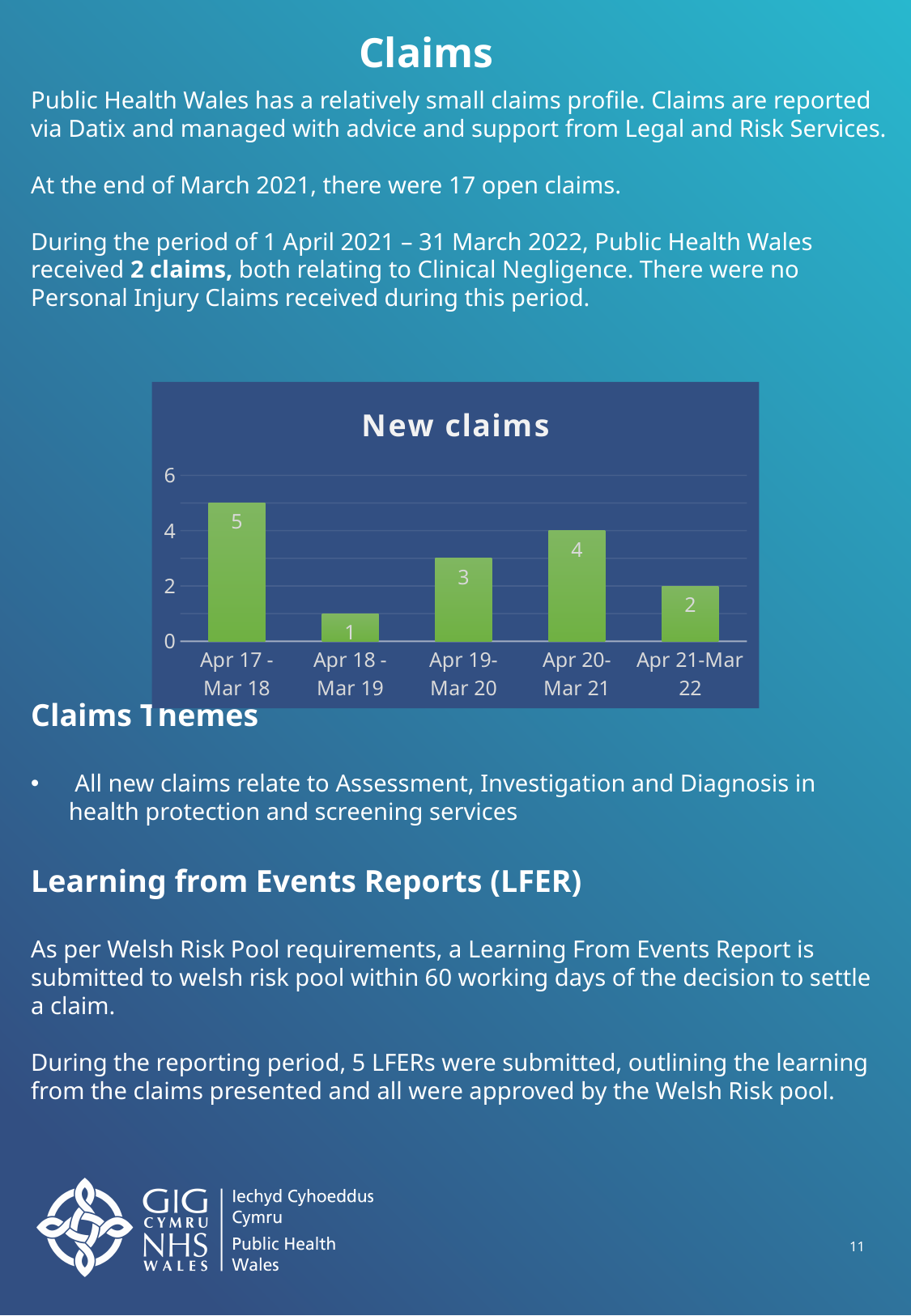
What is the difference in new claims between Apr 20 - Mar 21 and Apr 21 - Mar 22? 2 What is the title of the chart on the slide? New claims Which period had the lowest number of new claims? Apr 18 - Mar 19 How many periods are shown on the x axis of the chart? 5 Which period had the highest number of new claims? Apr 17 - Mar 18 What type of chart is shown on the slide? bar chart How many new claims were there in Apr 19 - Mar 20? 3 How many new claims were there in Apr 21 - Mar 22? 2 How many new claims were there in Apr 18 - Mar 19? 1 Did the number of new claims rise or fall from Apr 20 - Mar 21 to Apr 21 - Mar 22? fall Which period had more new claims, Apr 19 - Mar 20 or Apr 20 - Mar 21? Apr 20 - Mar 21 How many new claims were there in Apr 17 - Mar 18? 5